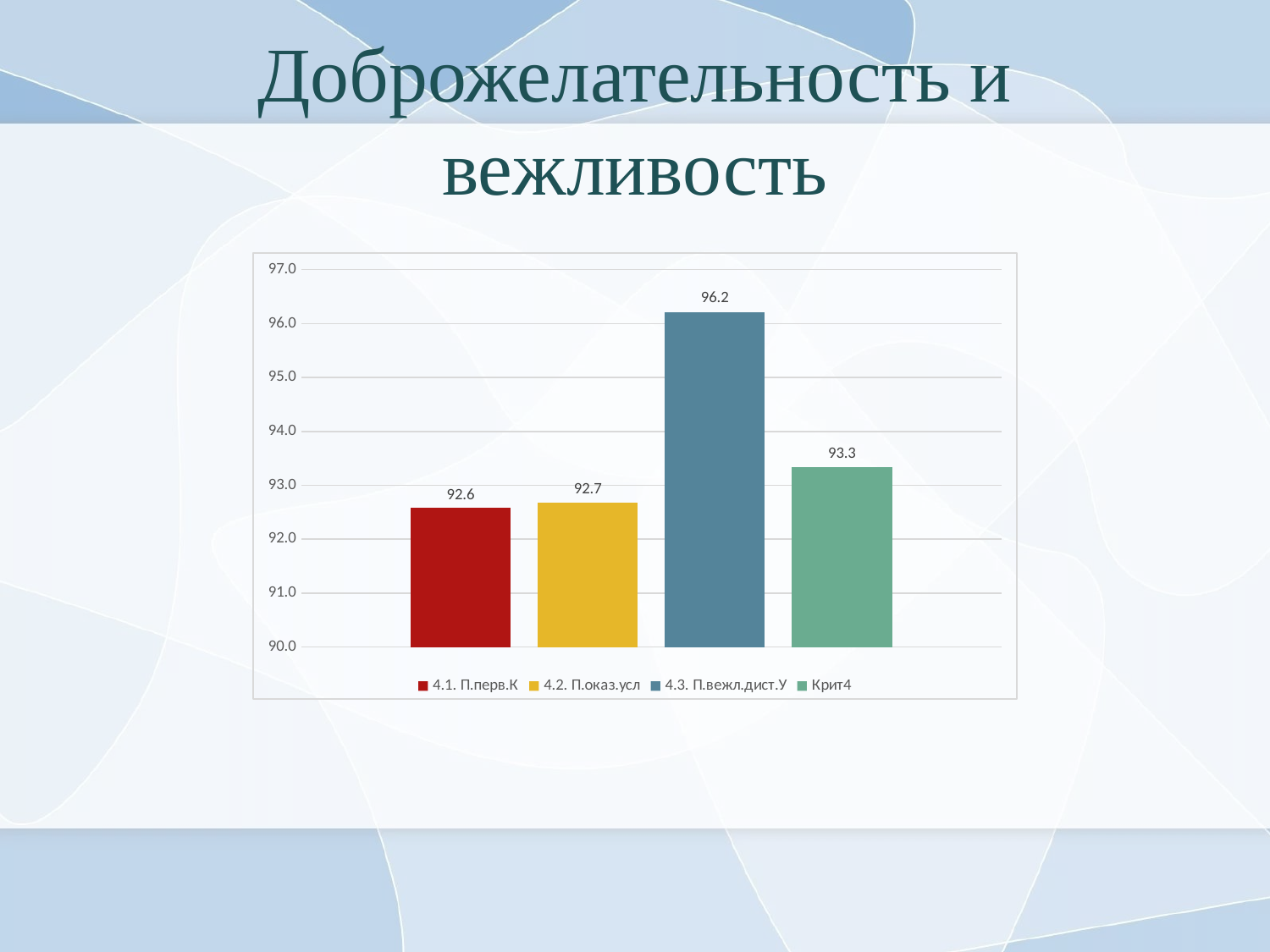
How many bars are shown in the chart? 4 What is the difference between the values for 4.2. П.оказ.усл and 4.1. П.перв.К? 0.1 What is the difference between the values for 4.3. П.вежл.дист.У and Крит4? 2.9 How many series does the legend list? 4 Which series has the lowest value? 4.1. П.перв.К Which series has the highest value? 4.3. П.вежл.дист.У What is the value for 4.1. П.перв.К? 92.6 What kind of chart is shown on the slide? bar chart What is the value for Крит4? 93.3 Is the value for 4.3. П.вежл.дист.У greater or less than 95.0? greater Which is larger, the value for Крит4 or the value for 4.2. П.оказ.усл? Крит4 What is the value for 4.3. П.вежл.дист.У? 96.2